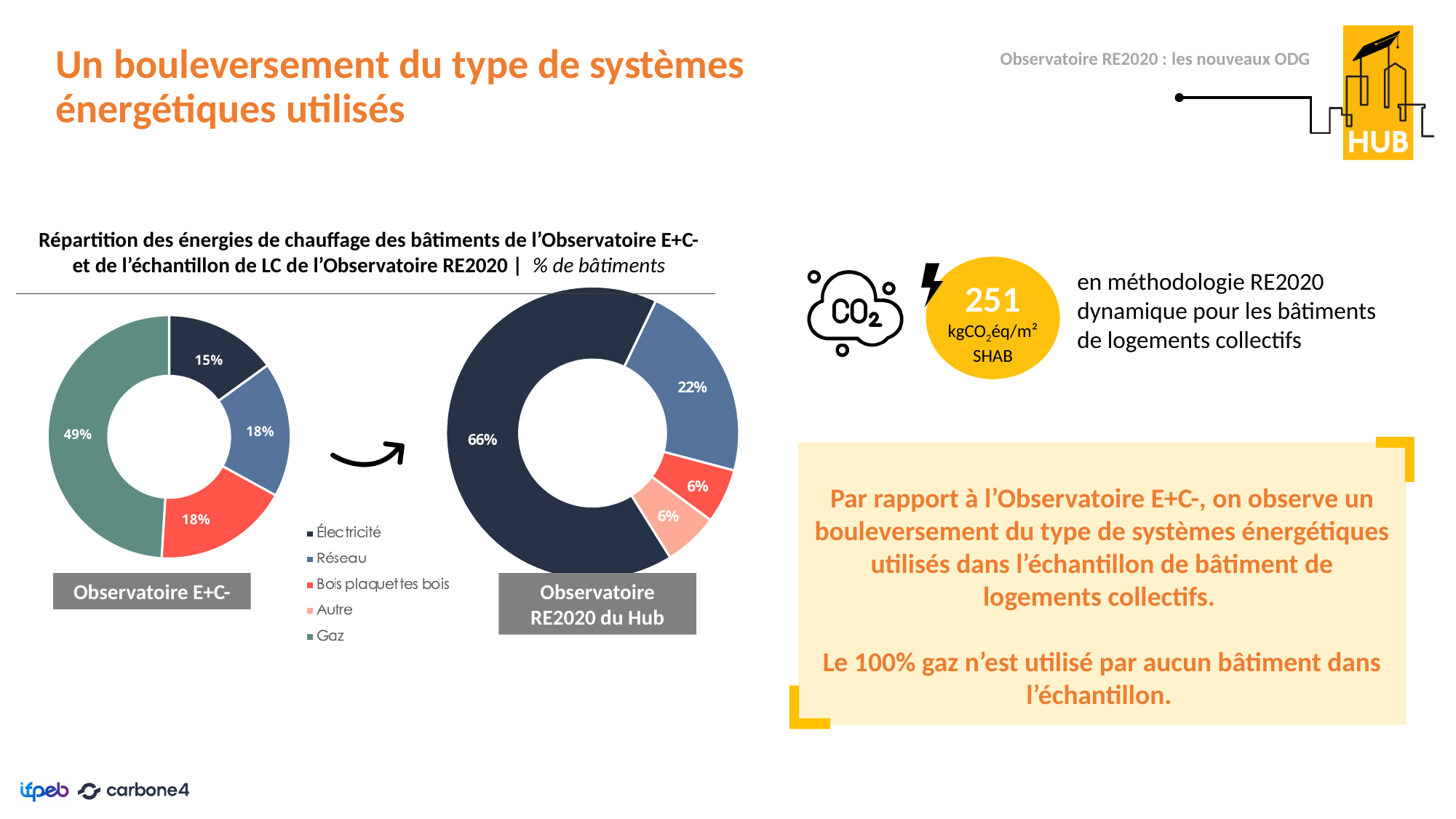
In the Observatoire E+C- donut chart, which energy has the largest share? Gaz In the Observatoire RE2020 du Hub donut chart, what share is Électricité? 66% How many entries does the shared legend list? 5 What type of chart is used to show the distribution of heating energies? Donut (pie) chart In the Observatoire E+C- donut chart, what share is Gaz? 49% In the Observatoire RE2020 du Hub donut chart, what share is Bois plaquettes bois? 6% In the Observatoire E+C- donut chart, what share is Électricité? 15% In the Observatoire RE2020 du Hub donut chart, what share is Réseau? 22% In the Observatoire E+C- donut chart, which is larger: Réseau or Électricité? Réseau In the Observatoire RE2020 du Hub donut chart, which energy has the largest share? Électricité In the Observatoire E+C- donut chart, which labelled energy has the smallest share? Électricité What is the difference between the Électricité share in the Observatoire RE2020 du Hub chart and in the Observatoire E+C- chart? 51%